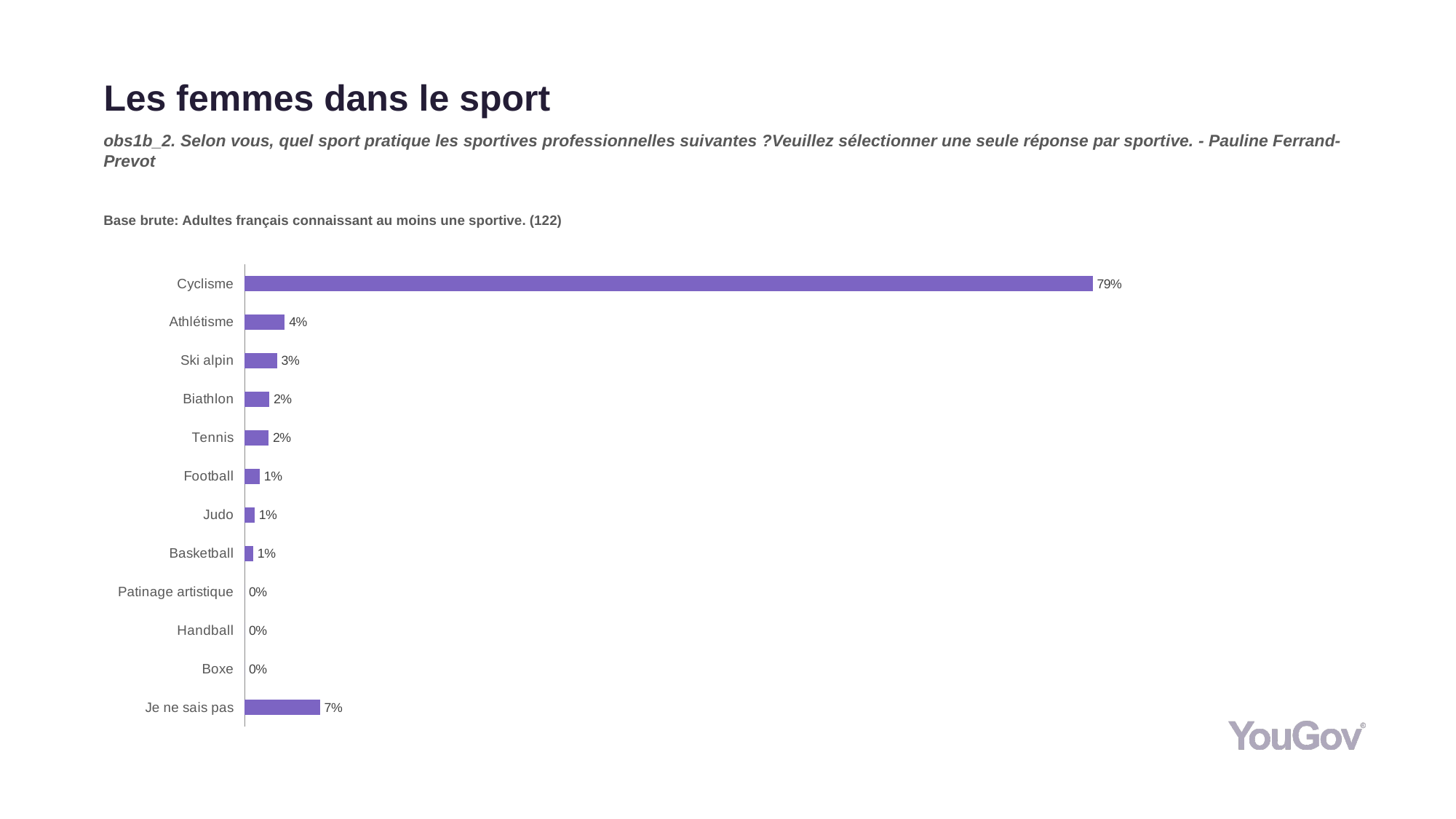
Which category has the highest value? Cyclisme What is the value for Ski alpin? 3% What is the difference between the values for Cyclisme and Je ne sais pas? 72% What is the difference between the values for Athlétisme and Ski alpin? 1% Which is larger, the value for Je ne sais pas or the value for Athlétisme? Je ne sais pas What is the value for Athlétisme? 4% What is the value for Cyclisme? 79% How many categories are shown in the chart? 12 What is the title of the slide? Les femmes dans le sport What kind of chart is shown on the slide? Bar chart How many categories have a value of 0%? 3 What is the value for Je ne sais pas? 7%